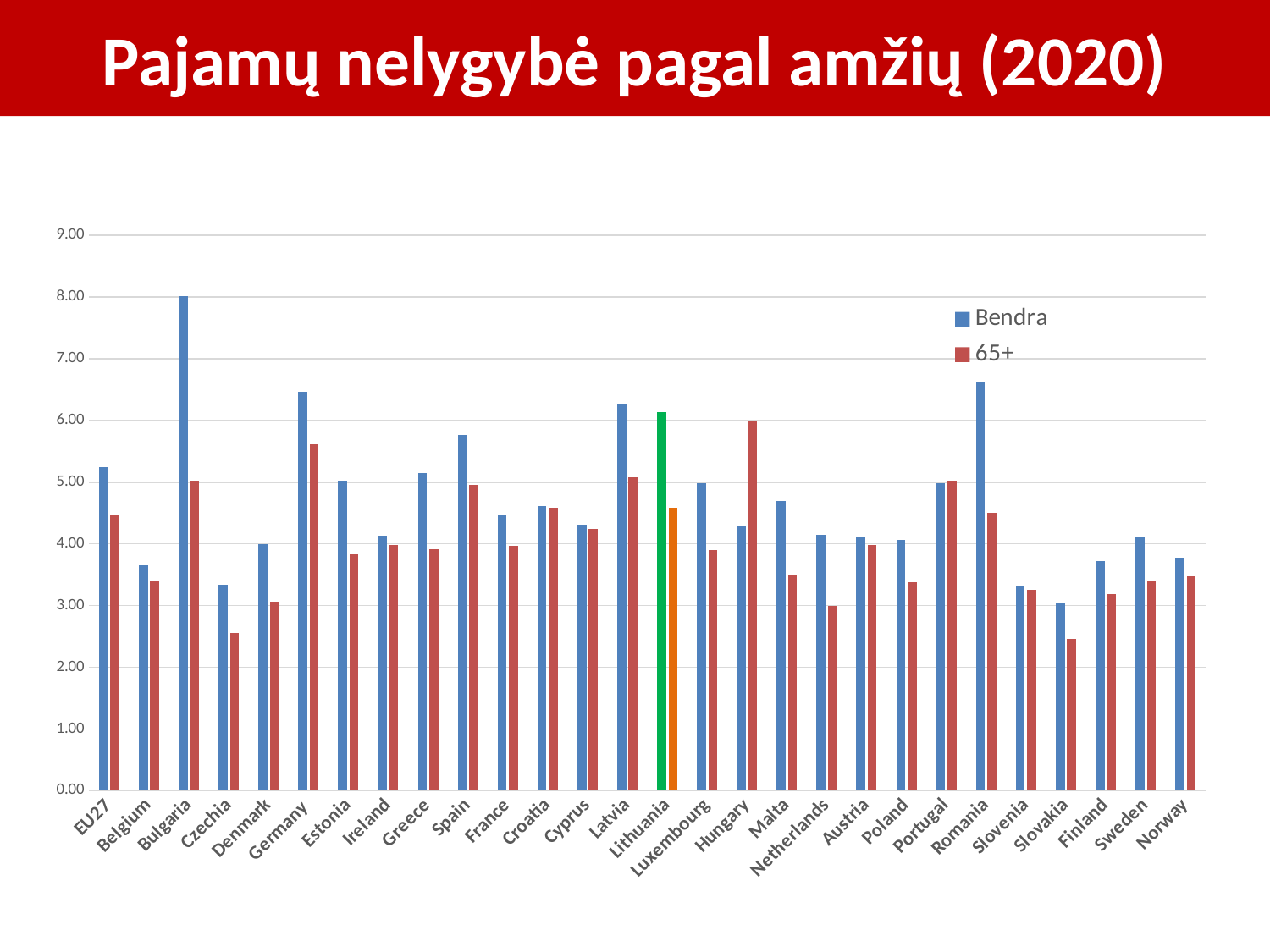
Which category has the lowest Bendra value? Slovakia Is the 65+ value for Czechia greater or less than 3.00? less For Hungary, which is larger: the Bendra value or the 65+ value? 65+ How many countries/categories are shown on the x axis? 28 Is the Bendra value for Bulgaria greater or less than 7.00? greater Is the Bendra value for Germany greater or less than 6.00? greater Which country's bars are highlighted in different colours (green and orange) from the rest? Lithuania What kind of chart is shown on the slide? bar chart Which category has the highest 65+ value? Hungary Which category has the highest Bendra value? Bulgaria How many series does the legend list? 2 Which is larger: the Bendra value for Spain or the Bendra value for Greece? Spain